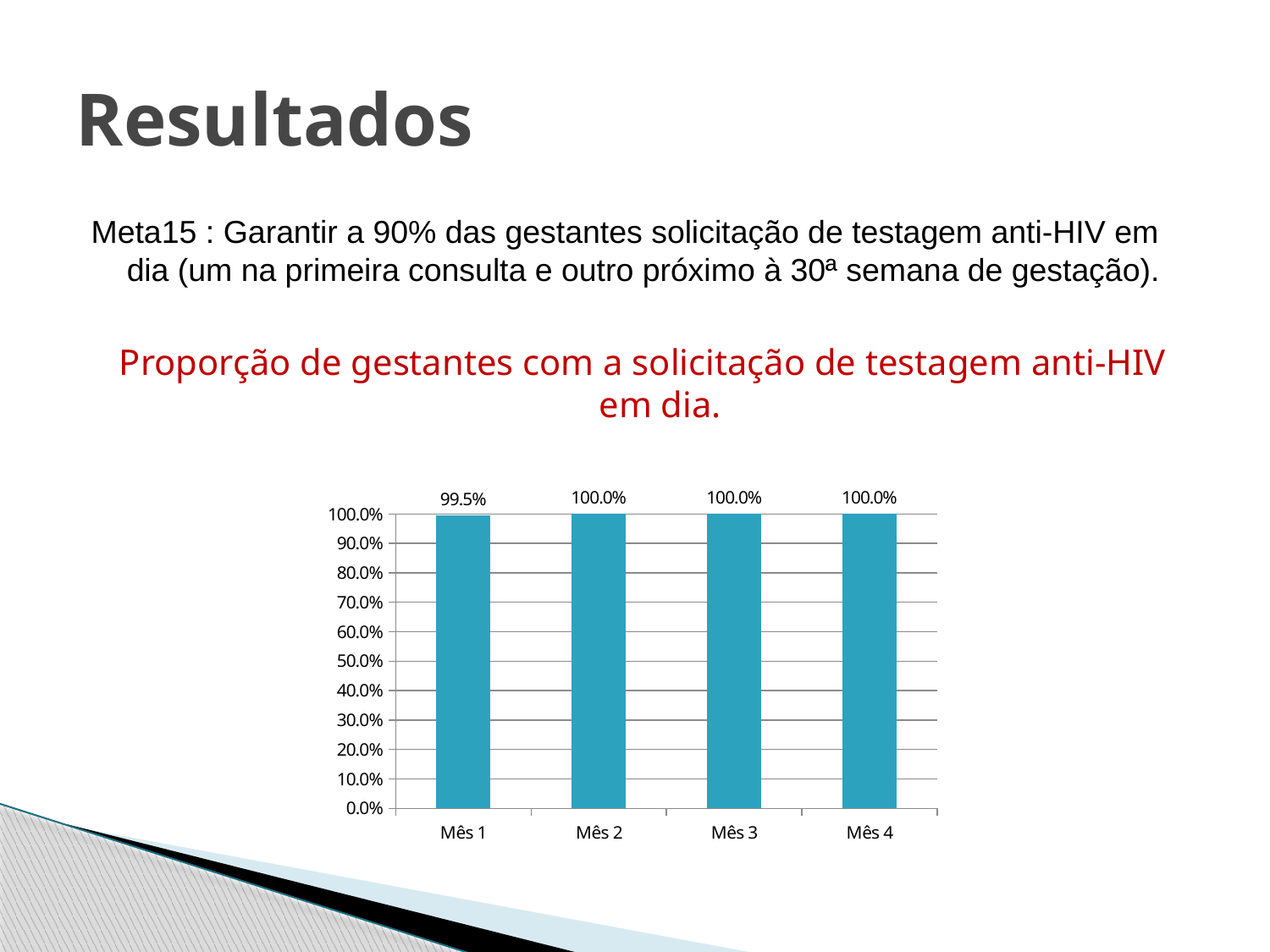
What is the value for Mês 4? 100.0% How many months are shown on the x axis? 4 How many months have a value of 100.0%? 3 Do the values rise or fall from Mês 1 to Mês 2? rise Is the value for Mês 3 greater or less than 90.0%? greater What is the value for Mês 1? 99.5% What is the highest value shown on the y axis? 100.0% What colour are the bars in the chart? blue Which month has the lowest value? Mês 1 What is the value for Mês 2? 100.0% What kind of chart is shown on the slide? bar chart What is the difference between the values for Mês 2 and Mês 1? 0.5%